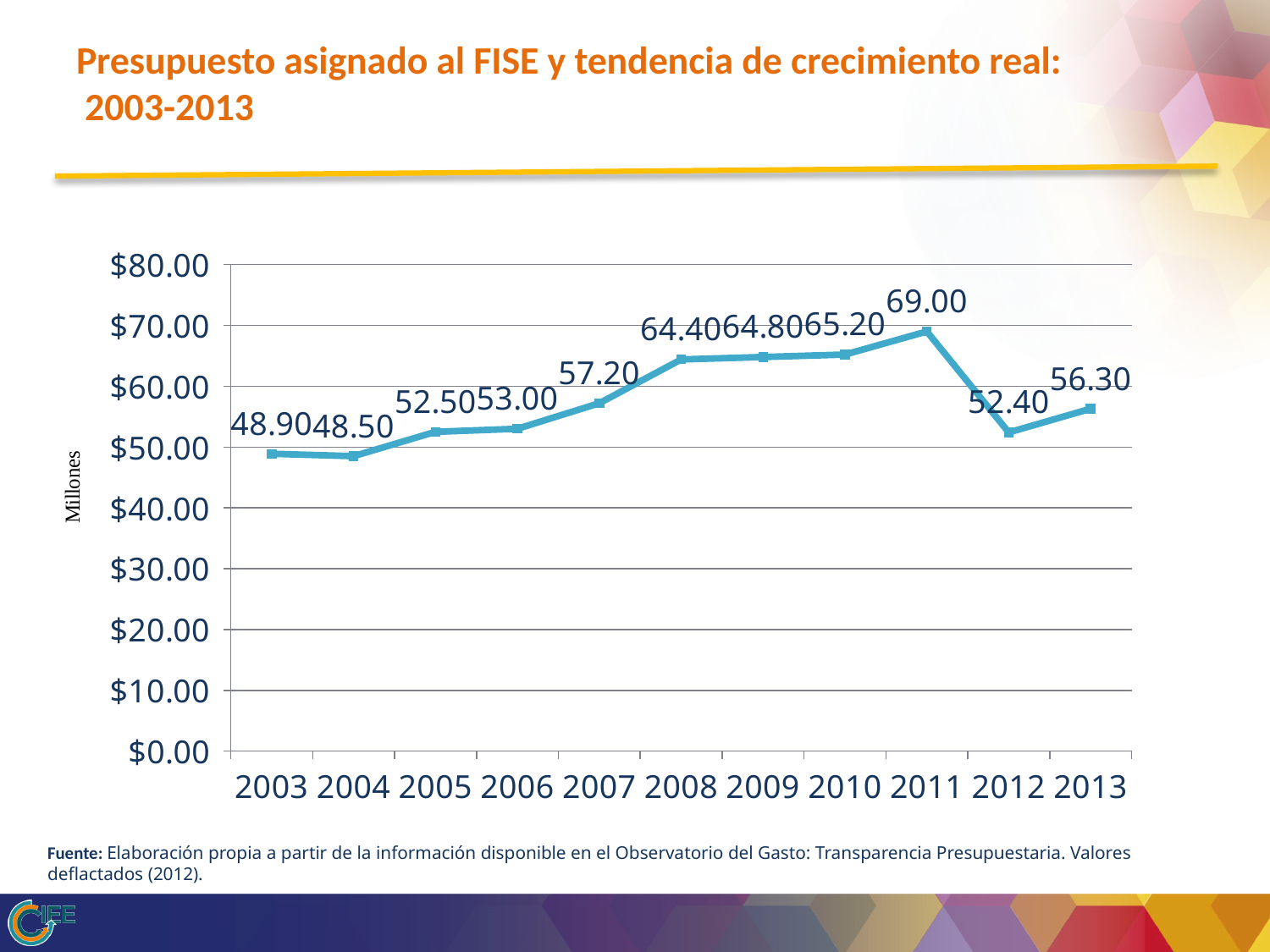
What is the difference between the values for 2011 and 2012? 16.60 Which year has the highest value? 2011 What is the label on the vertical axis? Millones What is the value for 2012? 52.40 Which is larger, the value for 2013 or the value for 2012? 2013 Do the values rise or fall from 2004 to 2011? rise What kind of chart is shown on the slide? line chart How many years are plotted on the x axis? 11 What is the value for 2003? 48.90 What is the value for 2011? 69.00 Is the value for 2008 greater or less than $60.00? greater Which year has the lowest value? 2004